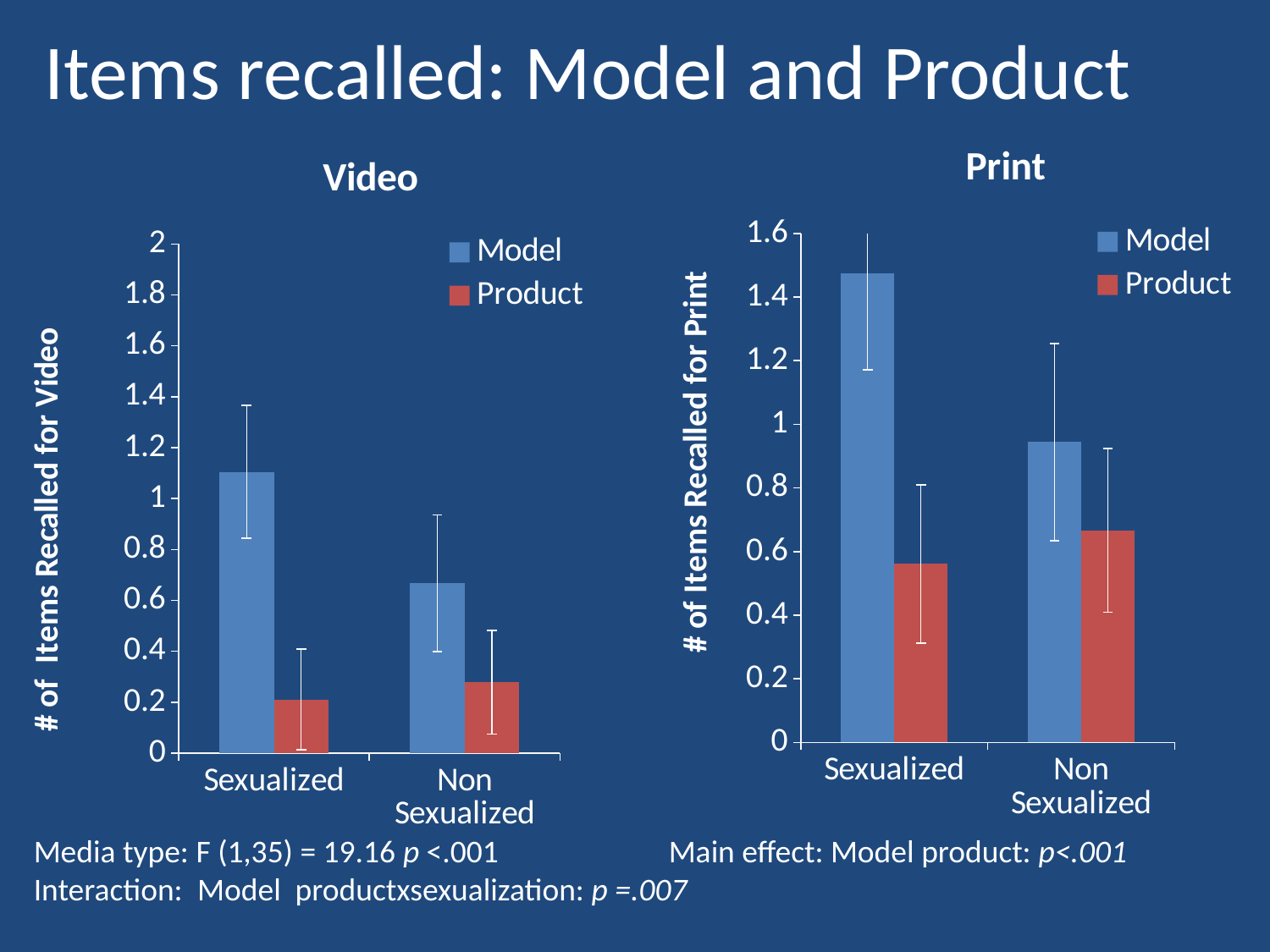
In the Video chart, does the Model series rise or fall from Sexualized to Non Sexualized? fall What kind of chart is the Video chart? bar chart In the Print chart, which bar is the tallest? Model, Sexualized In the Video chart, is the Model value for Sexualized greater or less than 1? greater What is the y-axis label of the Print chart? # of Items Recalled for Print In the Print chart, which bar is the shortest? Product, Sexualized In the Video chart, which bar is the shortest? Product, Sexualized In the Print chart, is the Product value for Non Sexualized greater or less than 0.8? less In the Print chart, which is larger for Non Sexualized: Model or Product? Model In the Video chart, which bar is the tallest? Model, Sexualized How many categories are shown on the x axis of the Video chart? 2 How many series does the legend of the Print chart list? 2